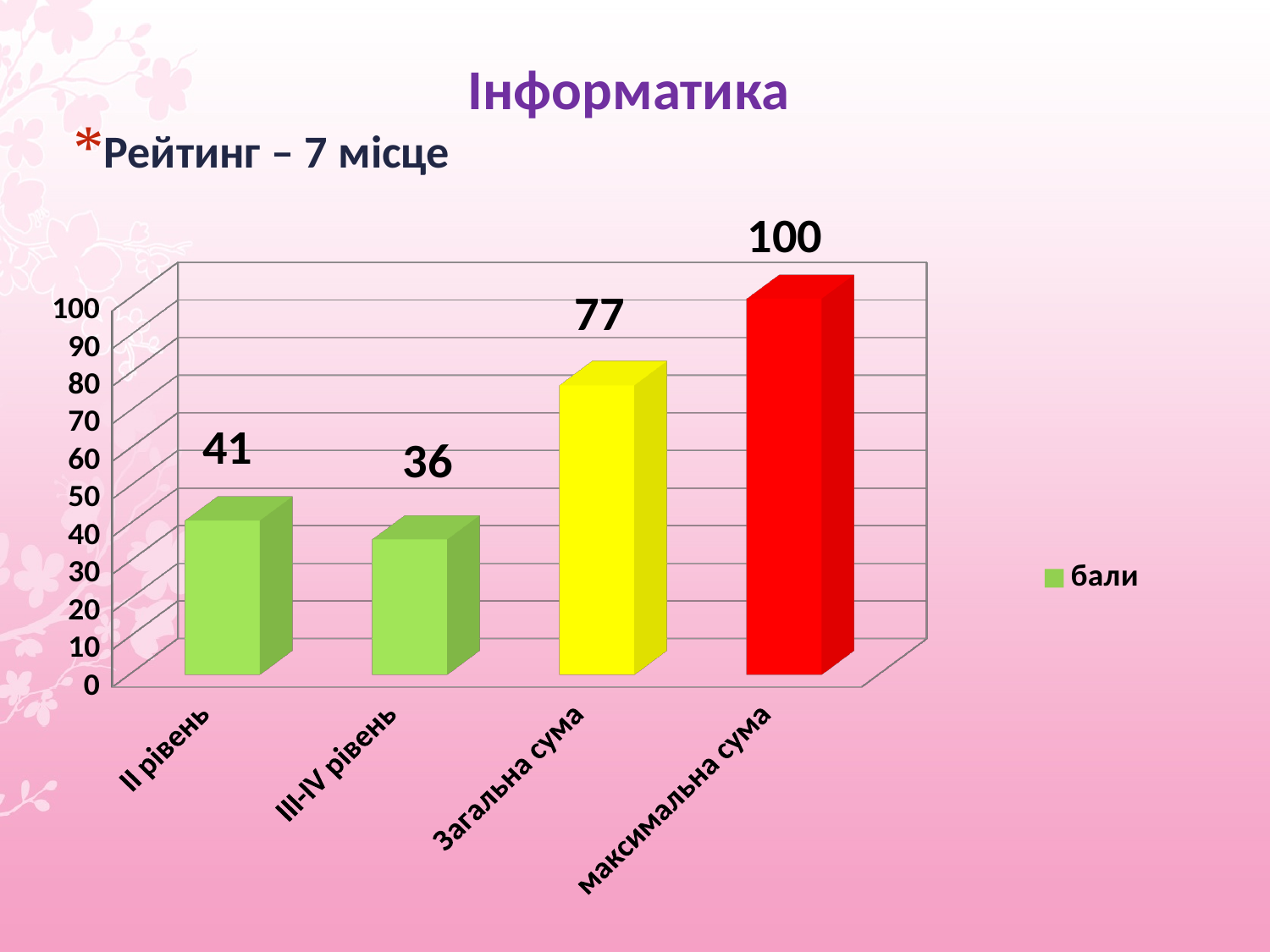
What is the difference between the values for максимальна сума and Загальна сума? 23 Which is larger, the value for II рівень or the value for III-IV рівень? II рівень What is the value for Загальна сума? 77 What is the name of the series listed in the legend? бали Which category has the highest value? максимальна сума What is the value for максимальна сума? 100 How many categories are shown on the x axis? 4 What is the value for II рівень? 41 Which category has the lowest value? III-IV рівень What is the value for III-IV рівень? 36 What is the difference between the values for II рівень and III-IV рівень? 5 What kind of chart is shown on the slide? bar chart